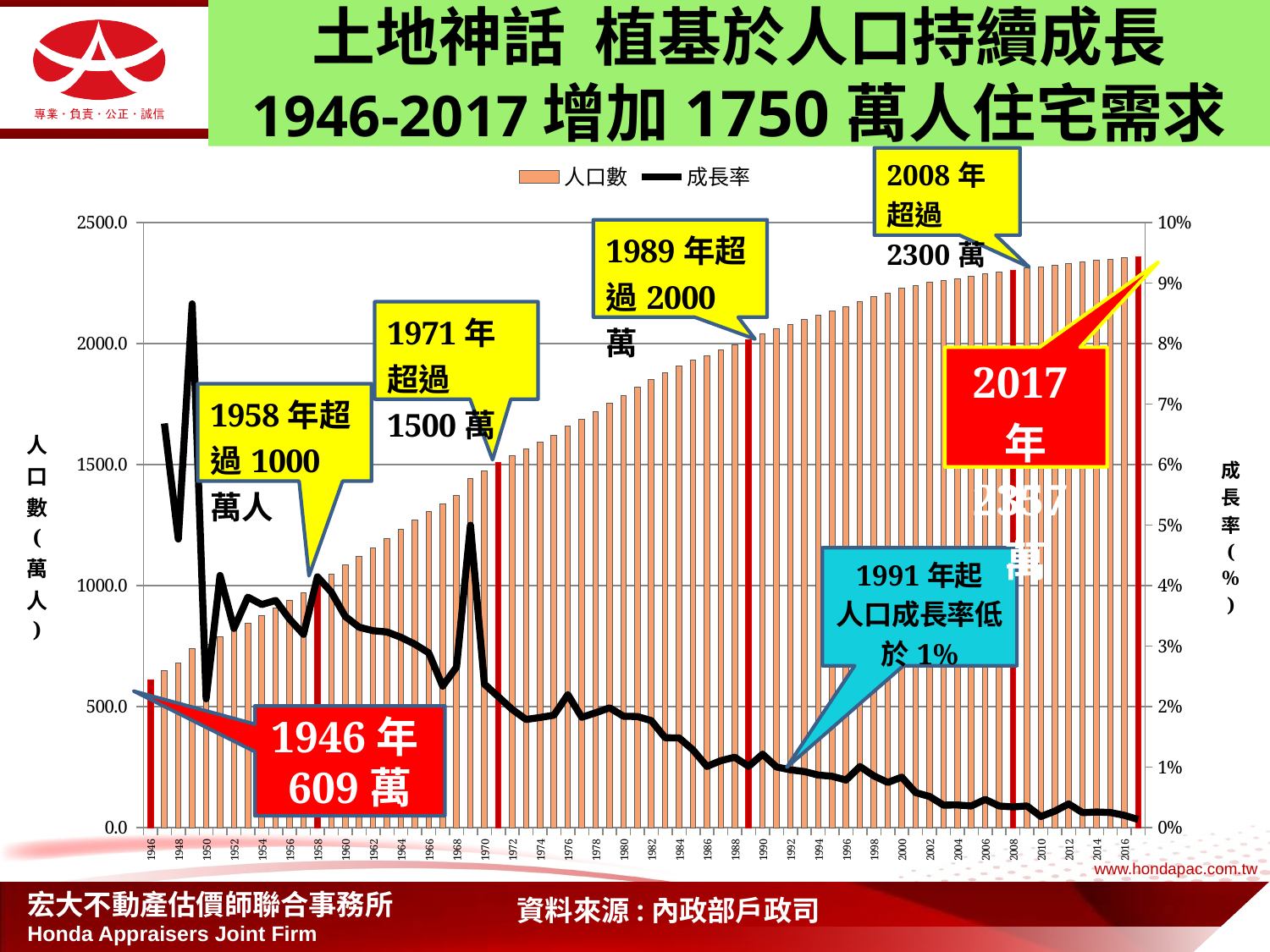
What is the maximum value shown on the right-hand growth rate axis? 10% Do the population (人口數) bars rise or fall from 1946 to 2017? Rise In which year did the population first exceed 1500 萬 according to the chart annotation? 1971 年 Is the growth rate for 2000 greater or less than 1%? less Does the growth rate (成長率) line generally rise or fall from 1950 to 2017? Fall What was the population in 1946 according to the chart annotation? 609 萬 How many series does the chart legend list? 2 In which year did the population exceed 2000 萬 according to the chart annotation? 1989 年 Which year has the lowest population bar on the chart? 1946 Is the population value for 2016 greater or less than 2000.0? greater What kind of chart is shown on the slide? Combination bar and line chart From which year has the population growth rate been below 1% according to the chart annotation? 1991 年